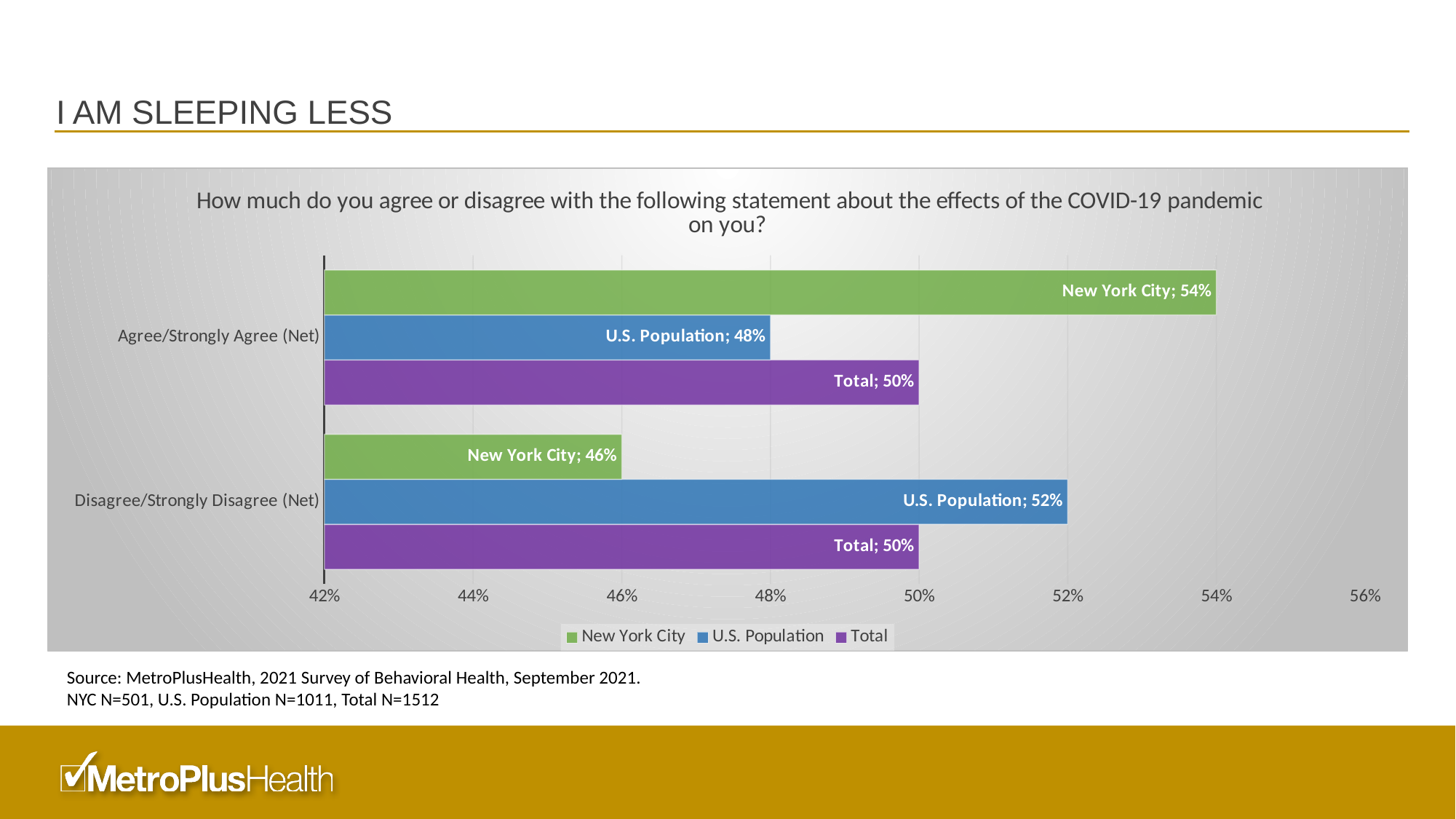
Which series has the lowest value in the Disagree/Strongly Disagree (Net) category? New York City What is the value for Total in the Agree/Strongly Agree (Net) category? 50% In the Disagree/Strongly Disagree (Net) category, which is larger: U.S. Population or Total? U.S. Population What colour represents the Total series in the chart? Purple What kind of chart is shown on the slide? Bar chart What is the difference between the New York City and U.S. Population values in the Agree/Strongly Agree (Net) category? 6% How many series does the legend list? 3 How many categories are shown on the chart? 2 Which series has the highest value in the Agree/Strongly Agree (Net) category? New York City What is the value for New York City in the Agree/Strongly Agree (Net) category? 54% What is the value for U.S. Population in the Disagree/Strongly Disagree (Net) category? 52% What is the value for New York City in the Disagree/Strongly Disagree (Net) category? 46%